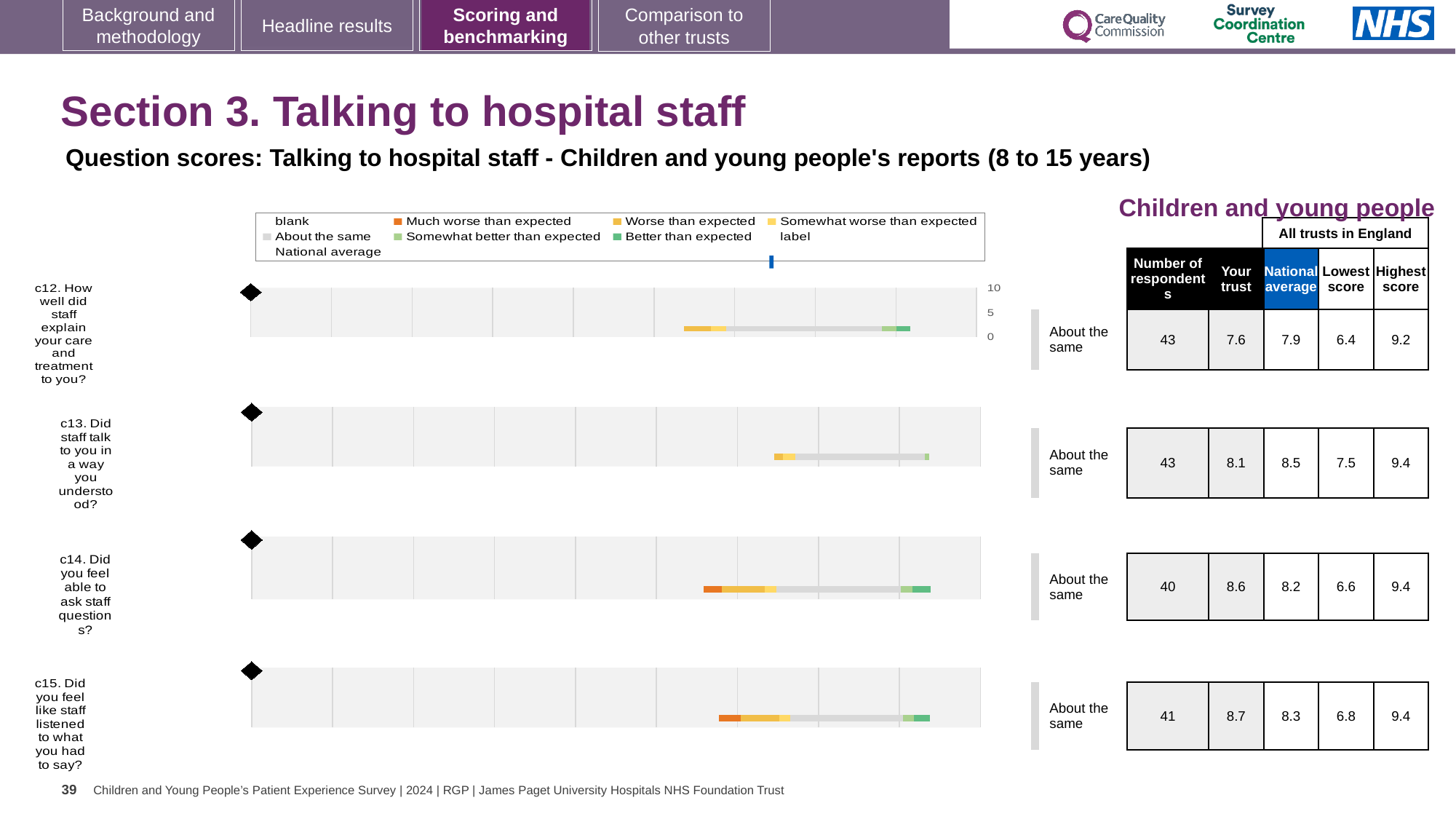
What is the lowest score across all trusts in England for c13? 7.5 For c14, which is larger: the 'Your trust' score or the national average? Your trust How many respondents answered c15 (Did you feel like staff listened to what you had to say?)? 41 Which question has the highest 'Your trust' score? c15 What benchmark category is shown for c12 (How well did staff explain your care and treatment to you?)? About the same What is the 'Your trust' score for c14 (Did you feel able to ask staff questions?)? 8.6 What kind of chart is used to show the benchmark bands for each question? bar chart What is the national average score for c13 (Did staff talk to you in a way you understood?)? 8.5 In the legend, what colour represents 'Much worse than expected'? orange For c12, what is the difference between the highest score and the lowest score across all trusts in England? 2.8 How many survey questions (c12 to c15) have a benchmark bar chart on this slide? 4 Which question has the lowest 'Your trust' score? c12